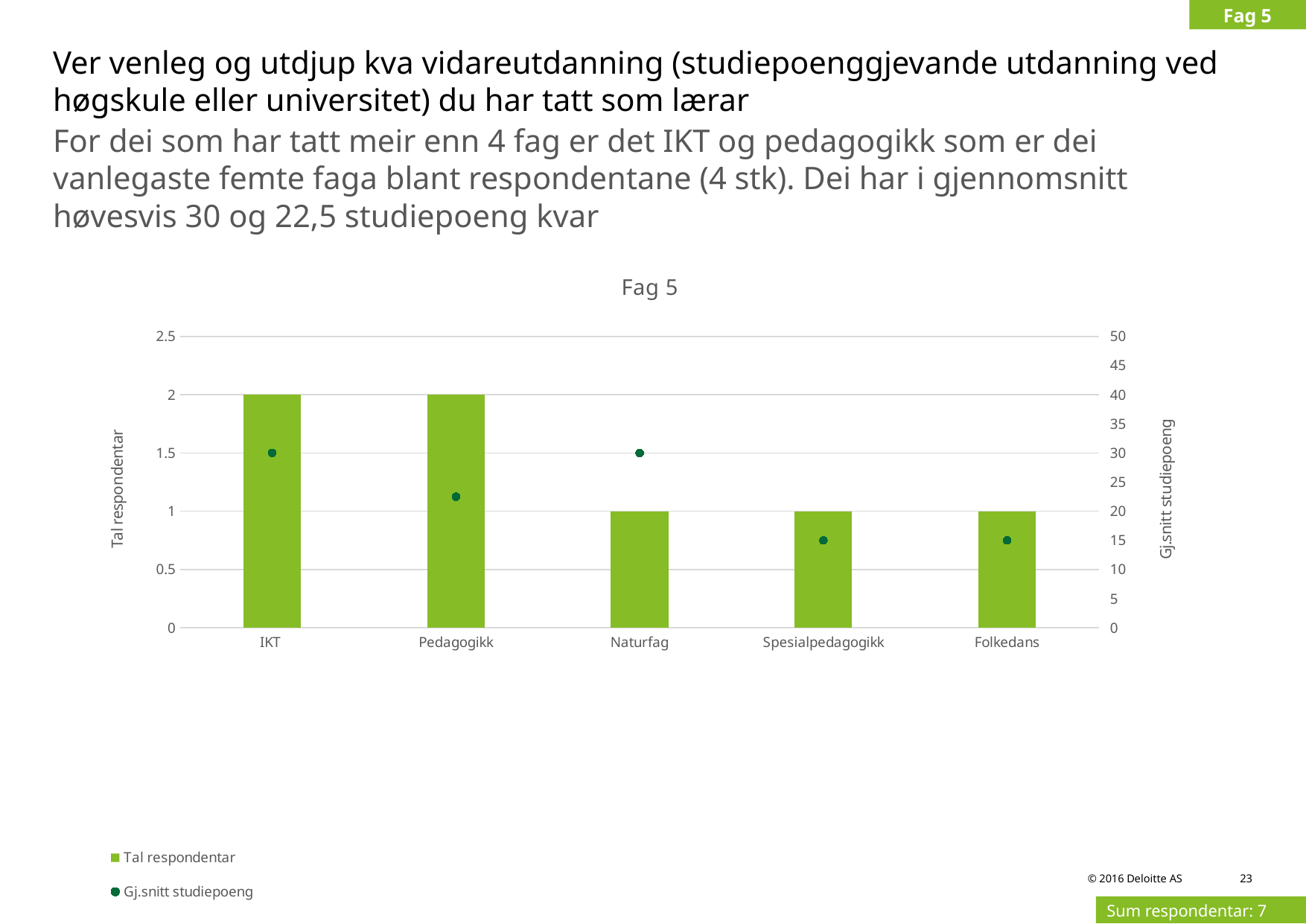
Which has the larger Tal respondentar value, IKT or Naturfag? IKT How many categories are shown on the x axis of the chart? 5 What is the Gj.snitt studiepoeng value for Spesialpedagogikk? 15 Is the Gj.snitt studiepoeng value for Pedagogikk greater or less than 20? greater Which has the larger Gj.snitt studiepoeng value, Naturfag or Folkedans? Naturfag What is the Tal respondentar value for Naturfag? 1 What kind of chart is shown on the slide? bar chart What is the title of the chart? Fag 5 What is the difference in Tal respondentar between IKT and Folkedans? 1 How many series does the legend list? 2 What is the Gj.snitt studiepoeng value for IKT? 30 What is the Tal respondentar value for IKT? 2